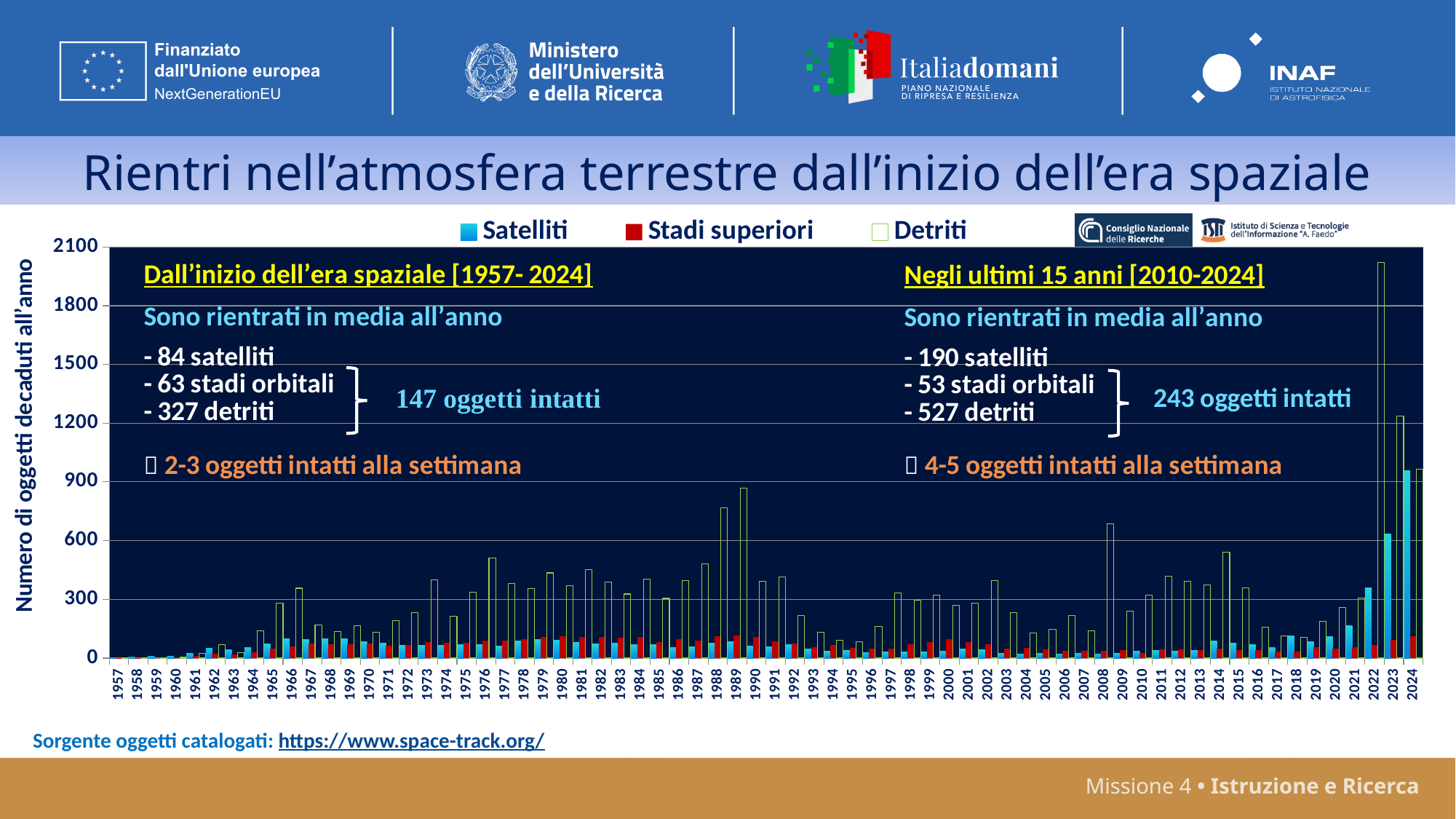
How many years are shown along the x axis of the chart? 68 How many series does the chart legend list? 3 Which series has the tallest bar in 2023? Detriti Is the Satelliti value for 2022 greater or less than 300? greater In which year does the Detriti series reach its highest value? 2022 Is the Detriti value for 1989 greater or less than 600? greater What are the three series named in the chart legend? Satelliti, Stadi superiori, Detriti What kind of chart is shown on the slide? bar chart Is the Detriti value for 2022 greater or less than 1800? greater What is the label of the vertical axis of the chart? Numero di oggetti decaduti all'anno Which is larger, the Detriti value for 2022 or the Detriti value for 2023? 2022